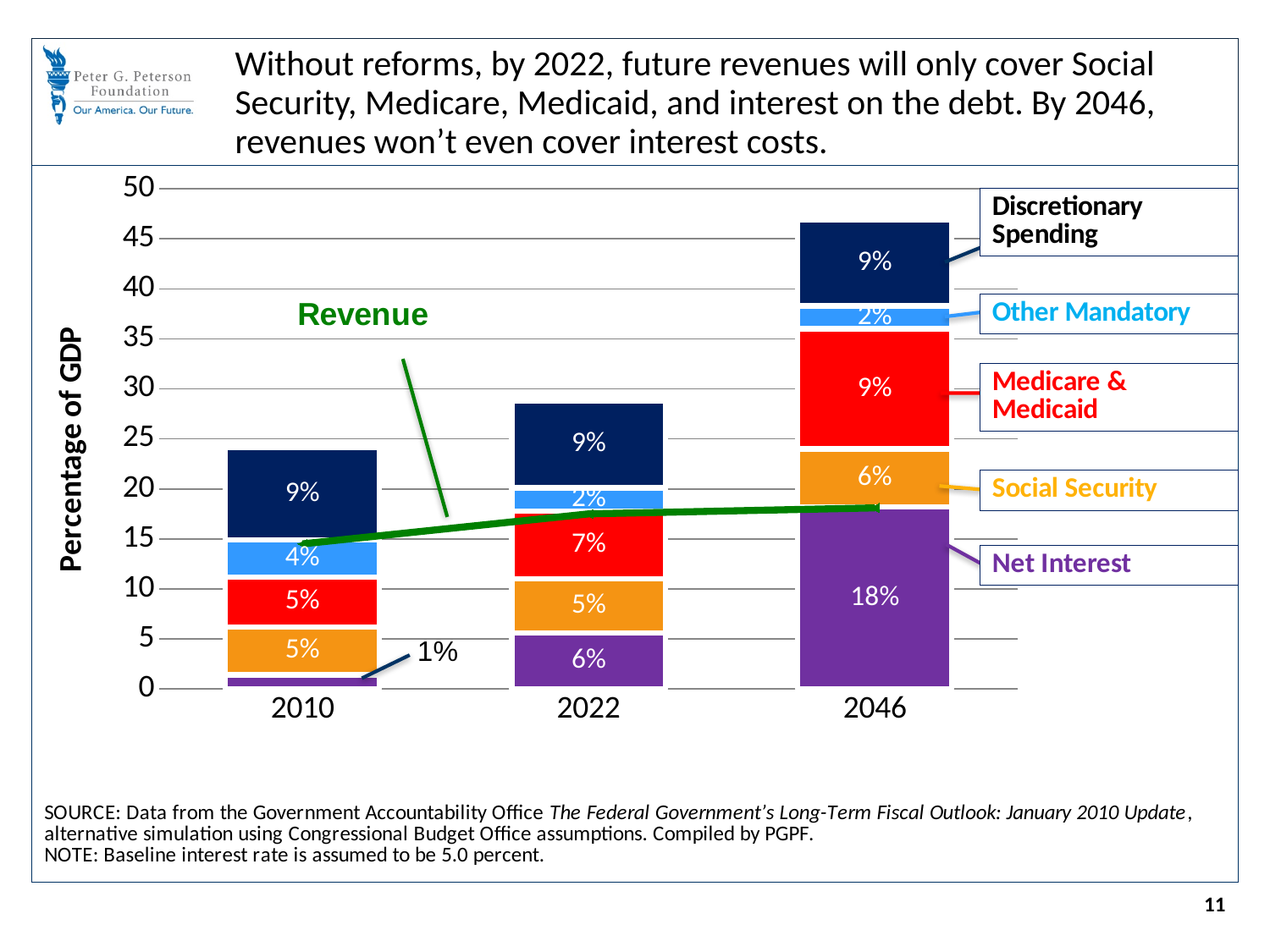
What kind of chart is shown on the slide? Stacked bar chart with a line (Revenue) What is the Other Mandatory value for 2010? 4% What is the Medicare & Medicaid value for 2022? 7% Is the Medicare & Medicaid value larger in 2046 or in 2010? 2046 What is the difference between the Net Interest values for 2046 and 2022? 12% What is the total of the stacked bar for 2010? 24% What is the Net Interest value for 2010? 1% How many years are shown on the x axis? 3 Which year has the highest Net Interest value? 2046 What is the Net Interest value for 2046? 18% Which year has the lowest Other Mandatory value? 2022 and 2046 (tied at 2%)